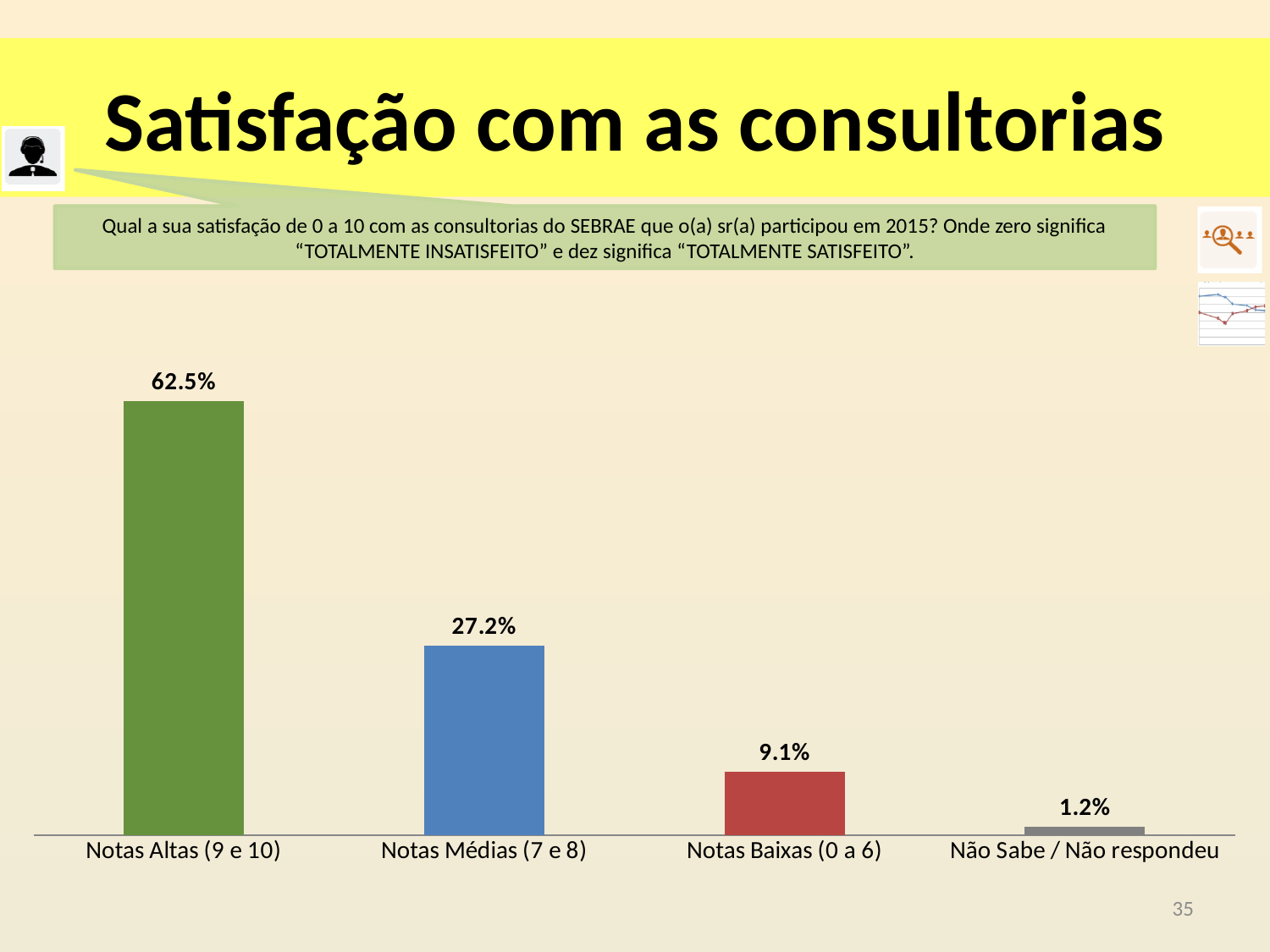
What is the value for Não Sabe / Não respondeu? 1.2% Which category has the lowest value? Não Sabe / Não respondeu What is the value for Notas Médias (7 e 8)? 27.2% What colour is the bar for Notas Baixas (0 a 6)? Red What is the value for Notas Altas (9 e 10)? 62.5% What is the difference between the values for Notas Altas (9 e 10) and Notas Médias (7 e 8)? 35.3% What is the value for Notas Baixas (0 a 6)? 9.1% Which category has the highest value? Notas Altas (9 e 10) What kind of chart is shown on the slide? Bar chart What is the difference between the values for Notas Baixas (0 a 6) and Não Sabe / Não respondeu? 7.9% How many categories are shown in the chart? 4 Which is larger, the value for Notas Médias (7 e 8) or the value for Notas Baixas (0 a 6)? Notas Médias (7 e 8)